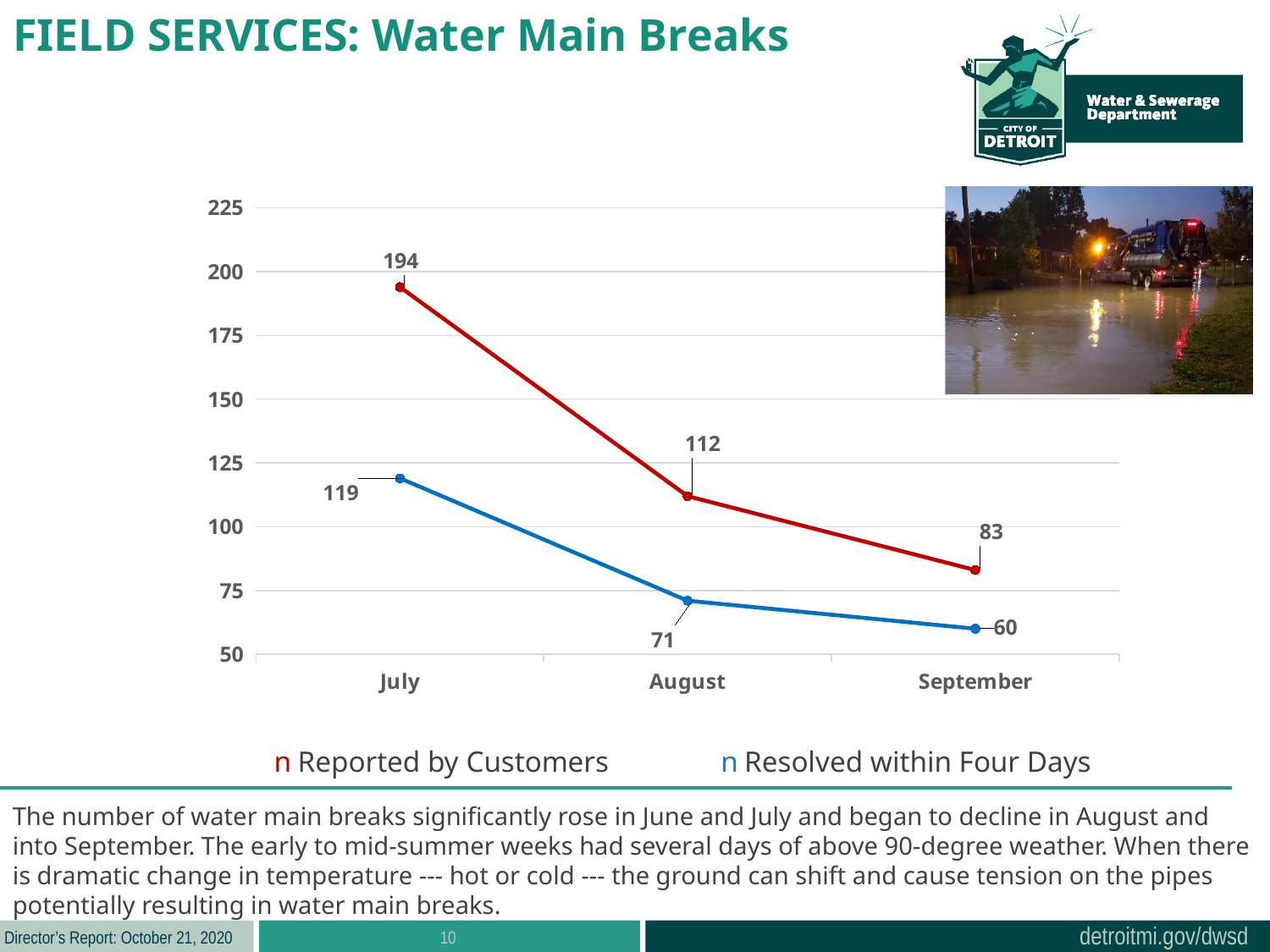
How many series does the legend list? 2 In which month is the Resolved within Four Days value lowest? September Do the Reported by Customers values rise or fall from July to September? fall How many months are shown on the x axis? 3 In which month is the Reported by Customers value highest? July What kind of chart is shown on the slide? line chart What is the value for Reported by Customers in September? 83 What is the value for Reported by Customers in July? 194 What is the difference between Reported by Customers and Resolved within Four Days in August? 41 What is the value for Resolved within Four Days in September? 60 Which is larger in July: Reported by Customers or Resolved within Four Days? Reported by Customers What is the value for Resolved within Four Days in August? 71